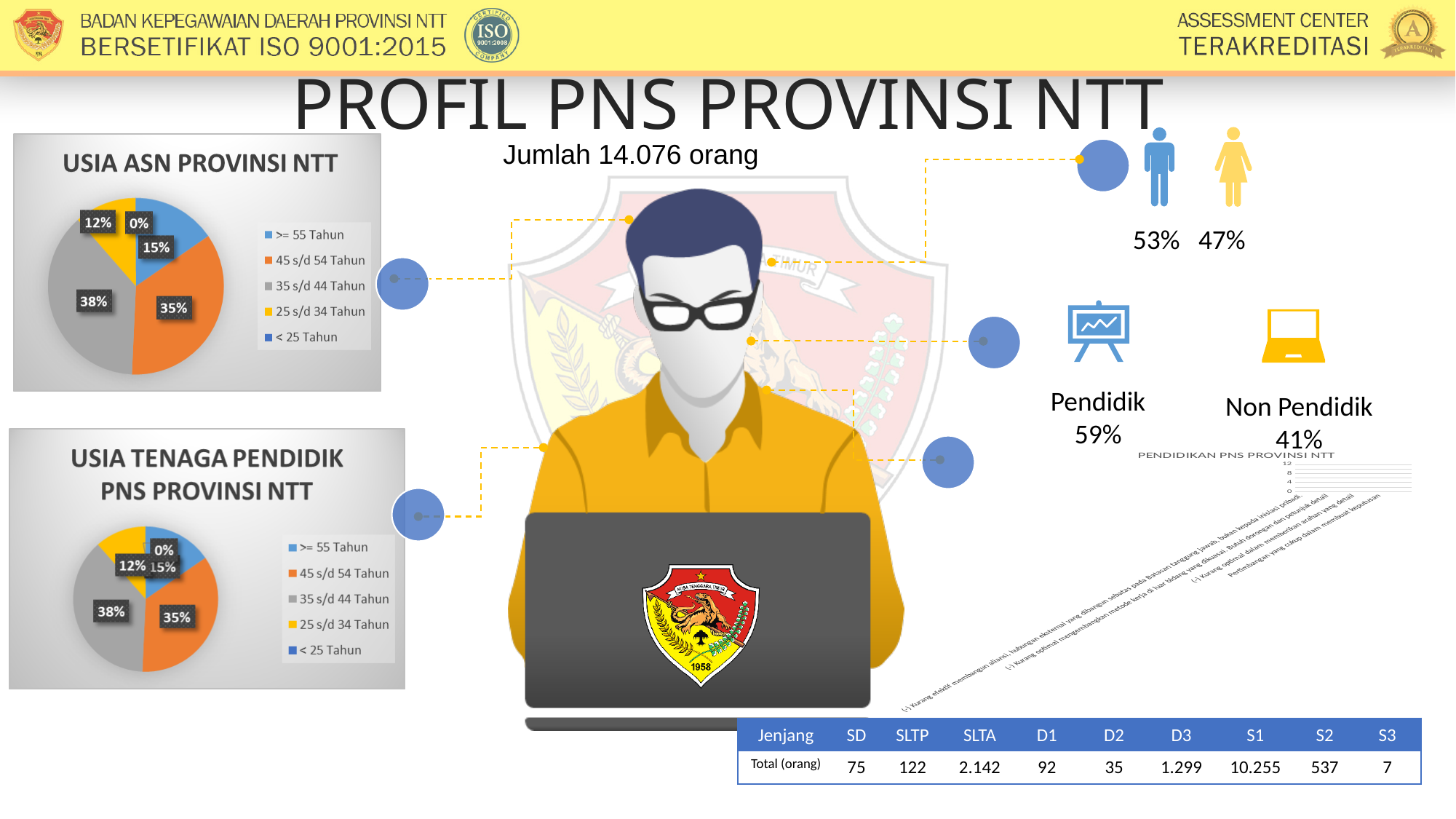
In the 'USIA ASN PROVINSI NTT' chart, what is the value for '>= 55 Tahun'? 15% In the 'USIA TENAGA PENDIDIK PNS PROVINSI NTT' chart, which colour represents '35 s/d 44 Tahun'? Gray How many categories does the legend of the 'USIA ASN PROVINSI NTT' chart list? 5 In the 'USIA ASN PROVINSI NTT' chart, which age group has the smallest share? < 25 Tahun What kind of chart is 'USIA ASN PROVINSI NTT'? Pie chart In the 'USIA ASN PROVINSI NTT' chart, what is the value for '45 s/d 54 Tahun'? 35% In the 'USIA TENAGA PENDIDIK PNS PROVINSI NTT' chart, what is the value for '< 25 Tahun'? 0% In the 'USIA TENAGA PENDIDIK PNS PROVINSI NTT' chart, which is larger, '45 s/d 54 Tahun' or '>= 55 Tahun'? 45 s/d 54 Tahun In the 'USIA ASN PROVINSI NTT' chart, what share of the pie is the '35 s/d 44 Tahun' slice? 38% In the 'USIA TENAGA PENDIDIK PNS PROVINSI NTT' chart, what is the value for '25 s/d 34 Tahun'? 12% In the 'USIA ASN PROVINSI NTT' chart, what is the difference between the '35 s/d 44 Tahun' and '25 s/d 34 Tahun' shares? 26% In the 'USIA ASN PROVINSI NTT' chart, which age group has the largest share? 35 s/d 44 Tahun